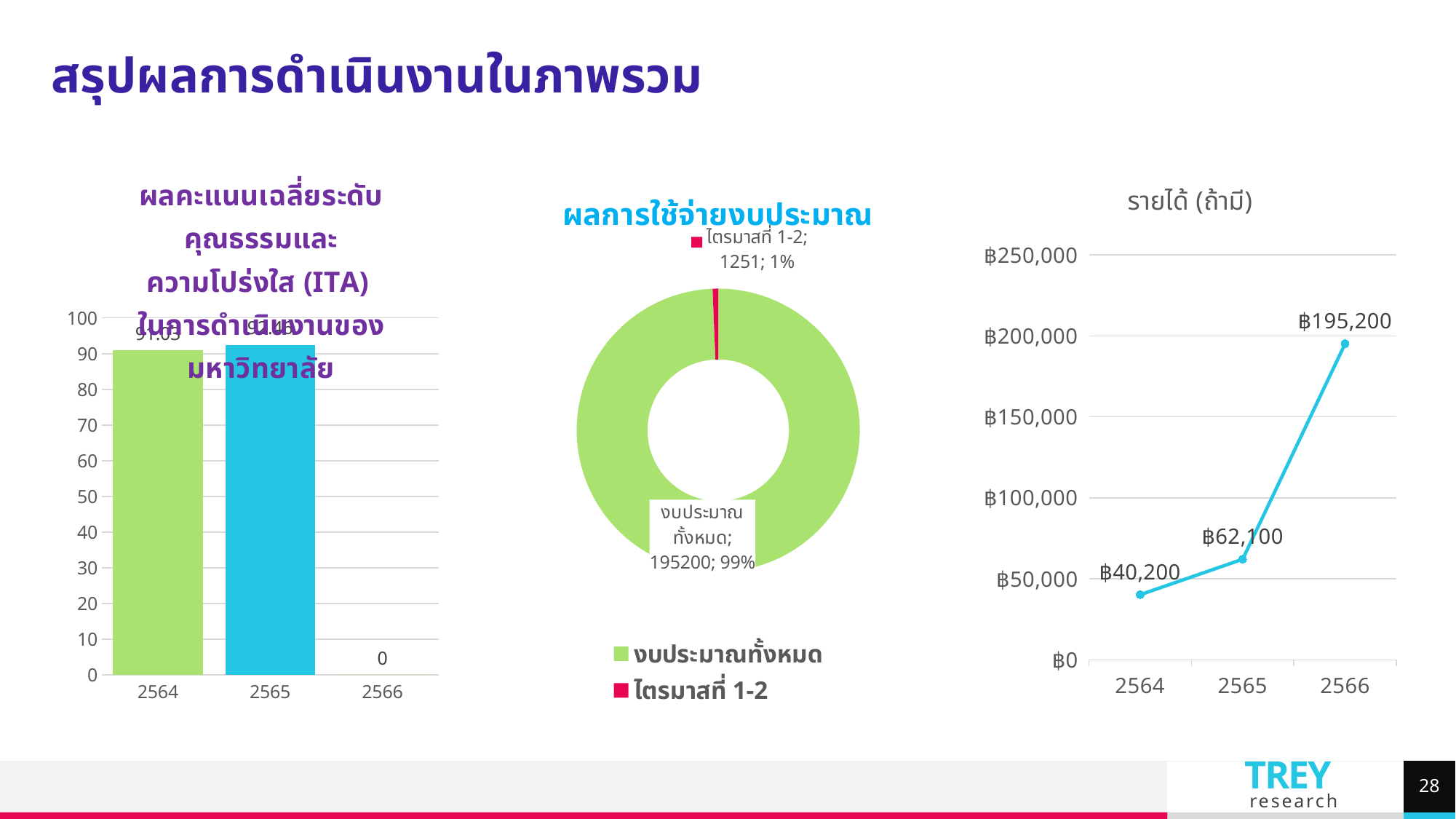
In the chart titled "รายได้ (ถ้ามี)", do the values rise or fall from 2564 to 2566? rise What kind of chart is the chart titled "รายได้ (ถ้ามี)"? line chart In the chart titled "ผลการใช้จ่ายงบประมาณ", what share of the doughnut does "ไตรมาสที่ 1-2" represent? 1% In the chart titled "รายได้ (ถ้ามี)", which year has the highest value? 2566 In the bar chart on the left of the slide, what is the value for 2566? 0 In the chart titled "รายได้ (ถ้ามี)", what is the value for 2566? ฿195,200 In the chart titled "รายได้ (ถ้ามี)", what is the value for 2564? ฿40,200 In the bar chart on the left of the slide, is the value for 2564 greater or less than 80? greater In the chart titled "รายได้ (ถ้ามี)", which year has the lowest value? 2564 How many entries does the legend of the chart titled "ผลการใช้จ่ายงบประมาณ" list? 2 In the chart titled "ผลการใช้จ่ายงบประมาณ", what is the value for "งบประมาณทั้งหมด"? 195200 In the chart titled "รายได้ (ถ้ามี)", what is the difference between the values for 2566 and 2565? ฿133,100